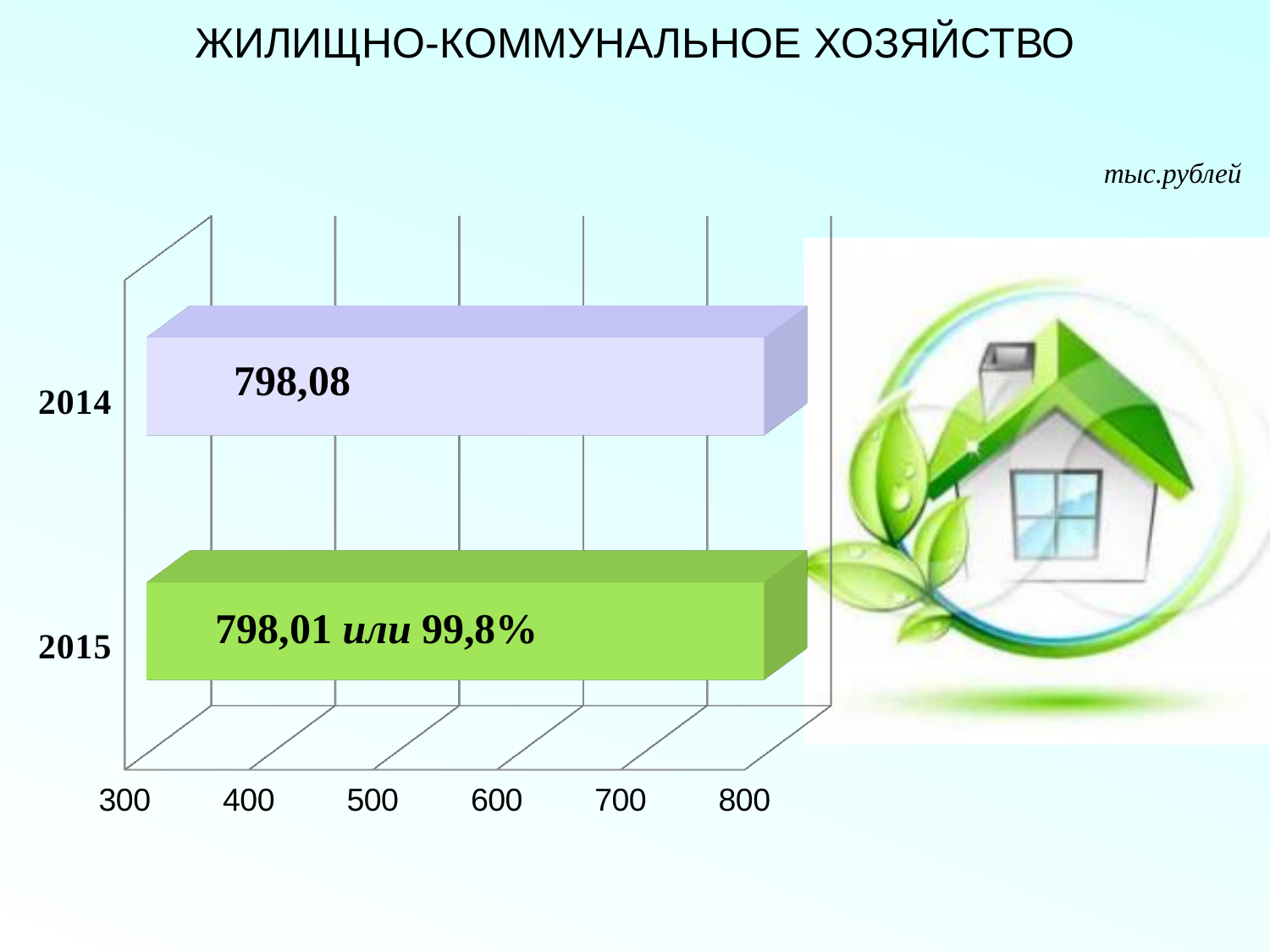
Do the values rise or fall from 2014 to 2015? fall What is the lowest value shown on the horizontal axis? 300 What percentage is shown on the 2015 bar? 99,8% What is the title of the slide? ЖИЛИЩНО-КОММУНАЛЬНОЕ ХОЗЯЙСТВО What is the value for 2015? 798,01 What unit of measurement is indicated for the chart? тыс.рублей What is the difference between the 2014 value and the 2015 value? 0,07 How many categories (years) are shown in the chart? 2 Is the value for 2014 greater or less than 700? greater Is the value for 2015 greater or less than 500? greater What is the value for 2014? 798,08 What kind of chart is shown on the slide? bar chart